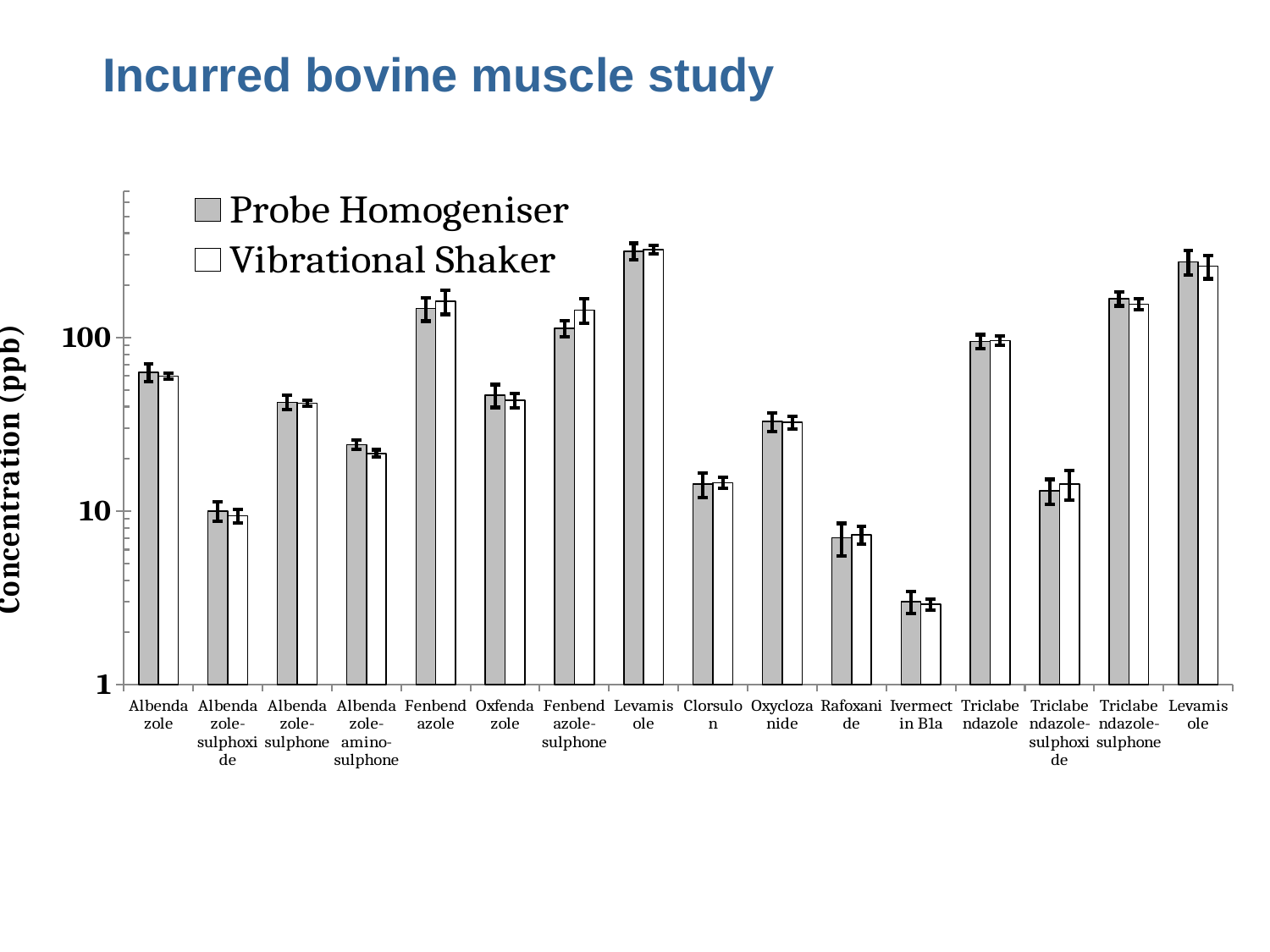
Is the Probe Homogeniser value for Fenbendazole greater or less than 100? greater Is the Probe Homogeniser value for Oxyclozanide greater or less than 10? greater Which has the larger Probe Homogeniser value, Fenbendazole or Oxfendazole? Fenbendazole How many categories are shown along the x axis? 16 Which has the larger Vibrational Shaker value, Triclabendazole or Triclabendazole-sulphoxide? Triclabendazole How many series does the legend list? 2 What kind of chart is shown on the slide? bar chart What is the label of the y axis? Concentration (ppb) Which category has the highest concentration for the Probe Homogeniser series? Levamisole Is the Vibrational Shaker value for Ivermectin B1a greater or less than 10? less Which category has the lowest concentration for the Vibrational Shaker series? Ivermectin B1a